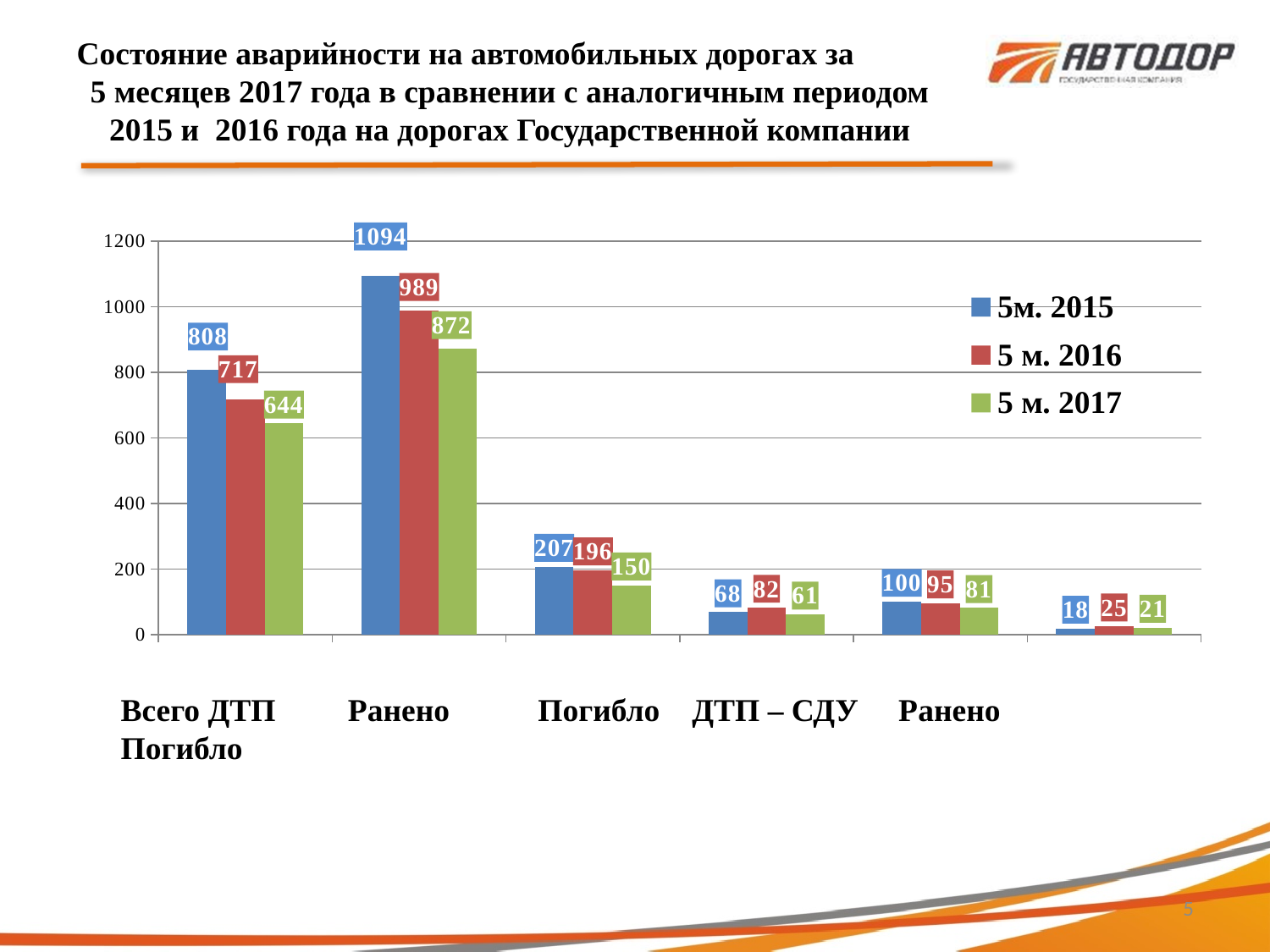
What kind of chart is shown on the slide? bar chart How many series does the legend list? 3 Which category has the highest value in the 5м. 2015 series? Ранено What is the difference between the 5м. 2015 and 5 м. 2017 values for Всего ДТП? 164 Which series has the lowest value for ДТП – СДУ? 5 м. 2017 What is the value for Всего ДТП in the 5м. 2015 series? 808 What is the value for the rightmost group (Погибло under ДТП – СДУ) in the 5 м. 2016 series? 25 What is the value for ДТП – СДУ in the 5 м. 2016 series? 82 What is the value for the first Ранено category (second group from the left) in the 5 м. 2016 series? 989 Which is larger for the first Погибло category (third group from the left): the 5м. 2015 value or the 5 м. 2017 value? 5м. 2015 Do the values for Всего ДТП rise or fall from 5м. 2015 to 5 м. 2017? fall What is the value for Всего ДТП in the 5 м. 2017 series? 644